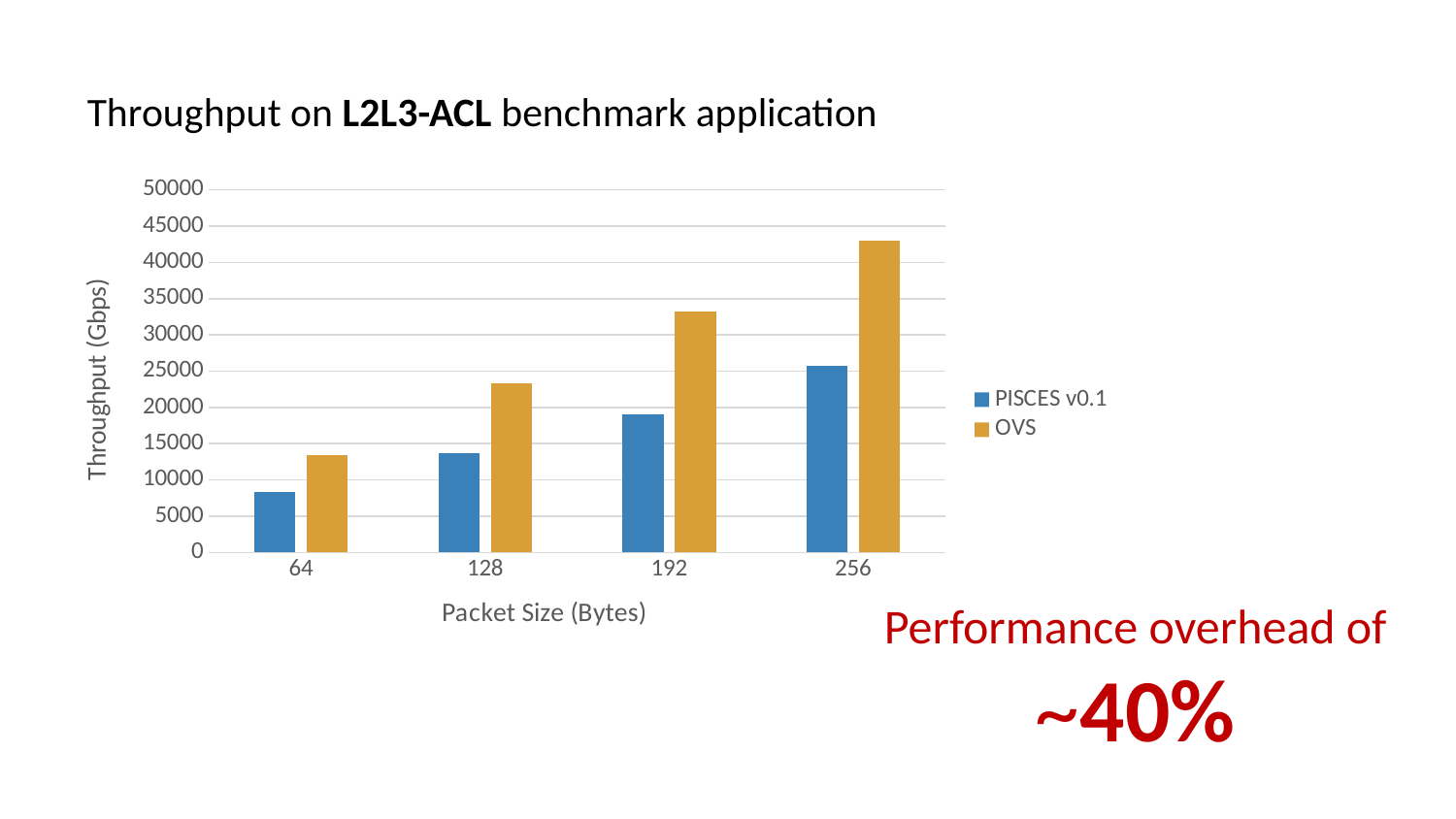
Which series has the higher throughput at a packet size of 256 bytes, PISCES v0.1 or OVS? OVS Is the OVS throughput at 192 bytes greater or less than 30000? greater How many packet size categories are shown on the x axis? 4 Is the PISCES v0.1 throughput at 256 bytes greater or less than 20000? greater How many series does the legend list? 2 Is the OVS throughput at 256 bytes greater or less than 40000? greater At which packet size is the PISCES v0.1 throughput lowest? 64 Does the OVS throughput rise or fall as packet size increases along the x axis? rise What type of chart is shown on the slide? bar chart What is the label of the y axis? Throughput (Gbps) At which packet size is the OVS throughput highest? 256